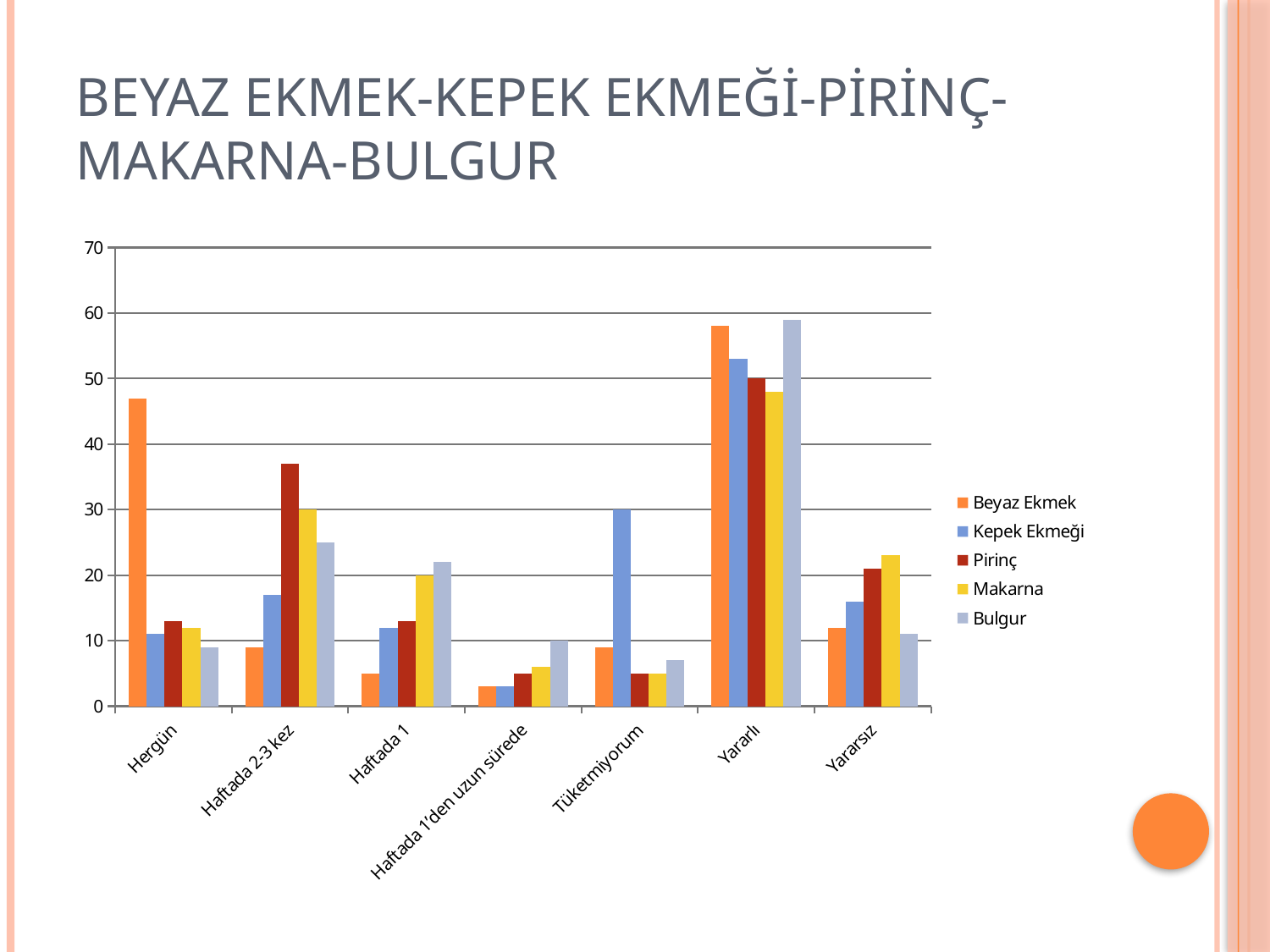
Which series is shown in yellow in the legend? Makarna Is the value for Bulgur in the Yararsız category greater or less than 20? less In the Yararsız category, which is larger: Makarna or Kepek Ekmeği? Makarna How many series does the legend list? 5 Which series has the highest value in the Tüketmiyorum category? Kepek Ekmeği What kind of chart is shown on the slide? bar chart Is the value for Beyaz Ekmek in the Hergün category greater or less than 40? greater Which series has the highest value in the Hergün category? Beyaz Ekmek Is the value for Pirinç in the Haftada 2-3 kez category greater or less than 30? greater Which series has the highest value in the Yararlı category? Bulgur How many categories are shown on the x axis? 7 Which series has the lowest value in the Haftada 1 category? Beyaz Ekmek